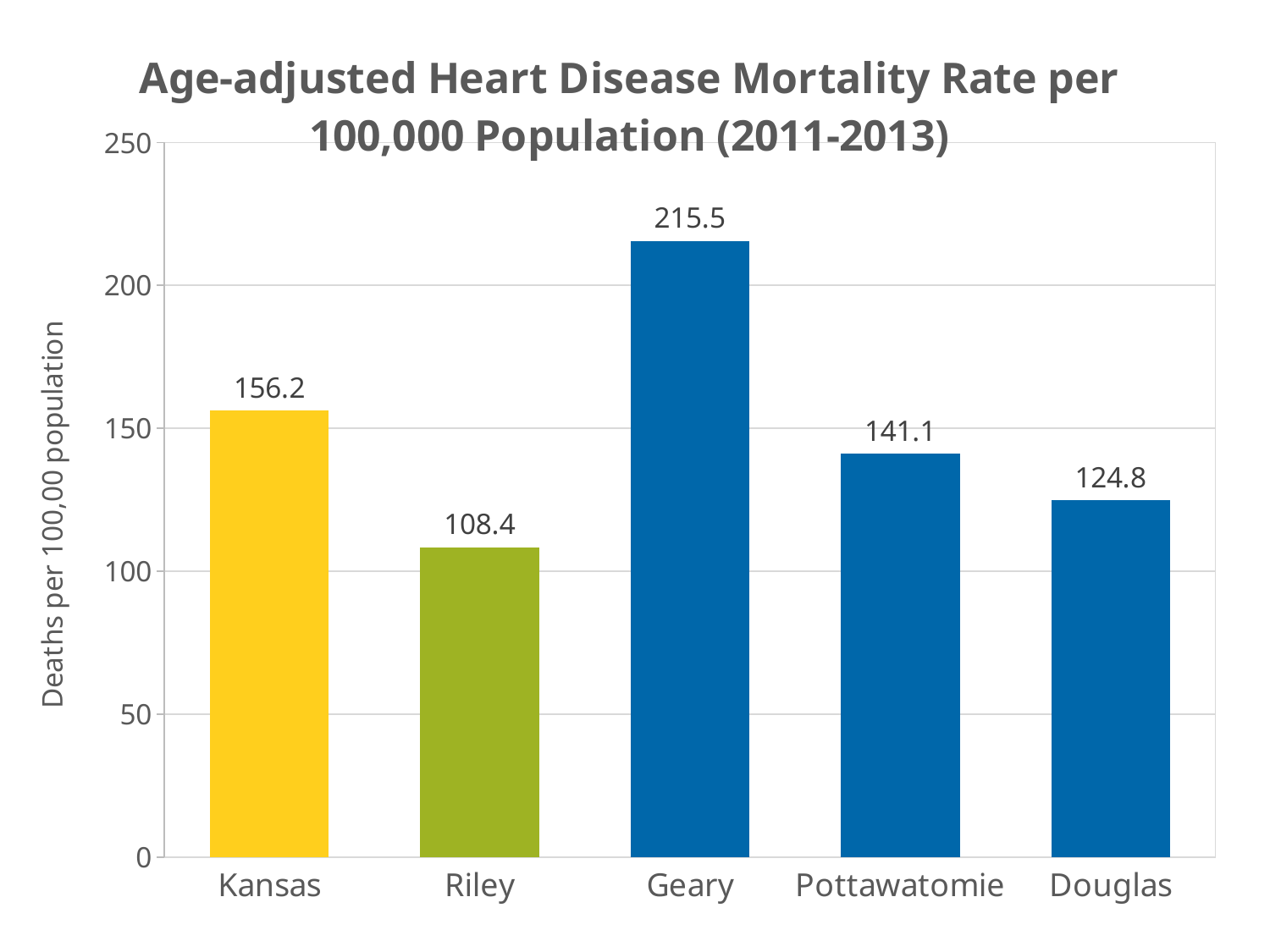
What is the difference between the mortality rates for Pottawatomie and Douglas? 16.3 What is the age-adjusted heart disease mortality rate for Pottawatomie? 141.1 Is the value for Geary greater or less than 200? greater What is the age-adjusted heart disease mortality rate for Riley? 108.4 What is the label of the vertical axis? Deaths per 100,00 population Which category has the lowest heart disease mortality rate? Riley What kind of chart is shown on the slide? Bar chart Which category has the highest heart disease mortality rate? Geary What is the difference between the mortality rates for Geary and Kansas? 59.3 How many categories are shown on the x axis? 5 Which has a higher heart disease mortality rate, Kansas or Douglas? Kansas What is the age-adjusted heart disease mortality rate for Kansas? 156.2